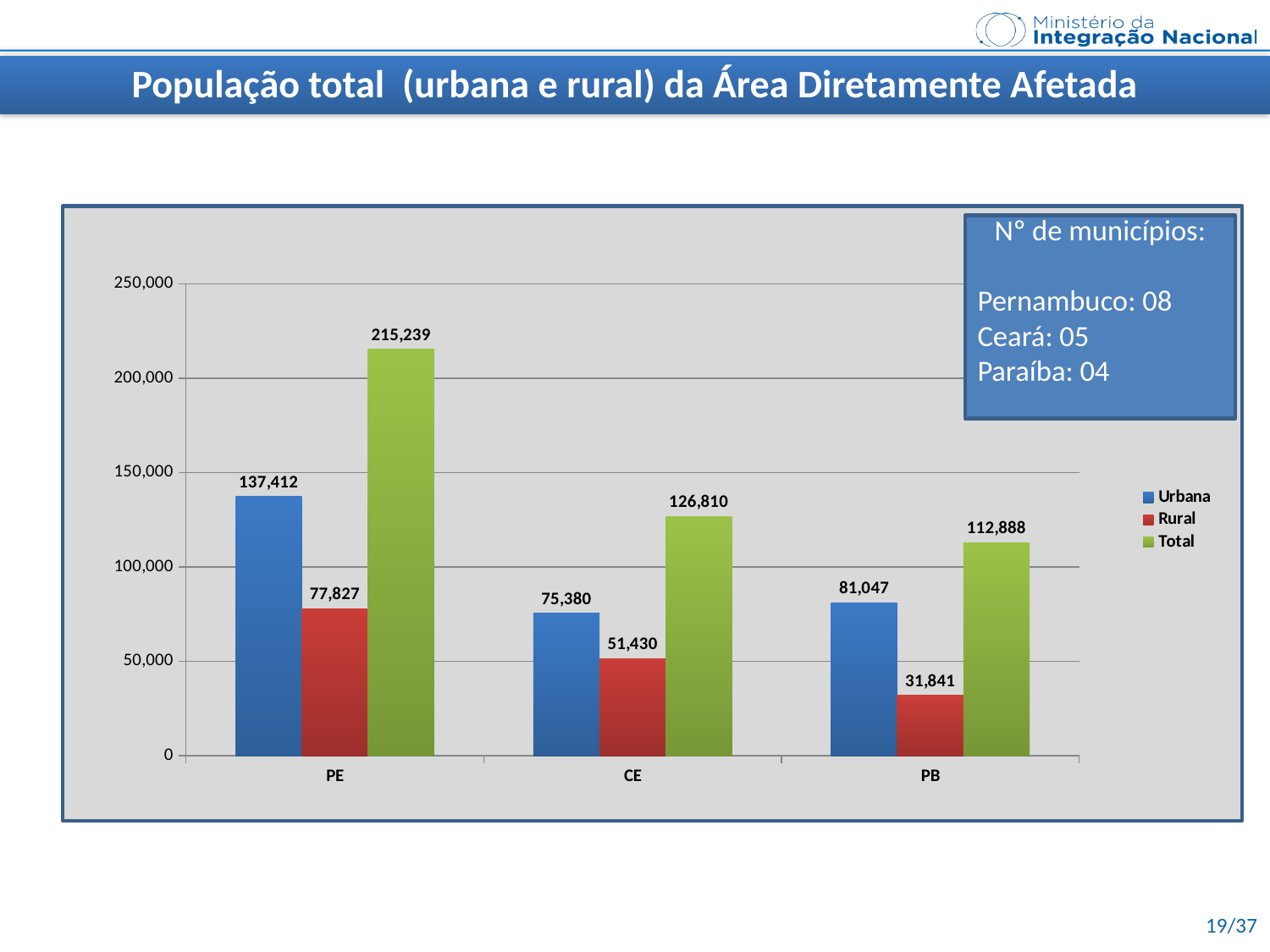
Which category has the lowest Rural value? PB What is the Rural value for CE? 51,430 Is the Total value for CE greater or less than 100,000? greater Which category has the highest Total value? PE What is the difference between the Urbana values for PE and CE? 62,032 What is the Total value for PB? 112,888 What kind of chart is shown on the slide? bar chart Which is larger, the Urbana value for PB or the Urbana value for CE? PB How many categories are shown on the x axis? 3 What is the Urbana value for PE? 137,412 How many series does the legend list? 3 What colour are the Total bars? green